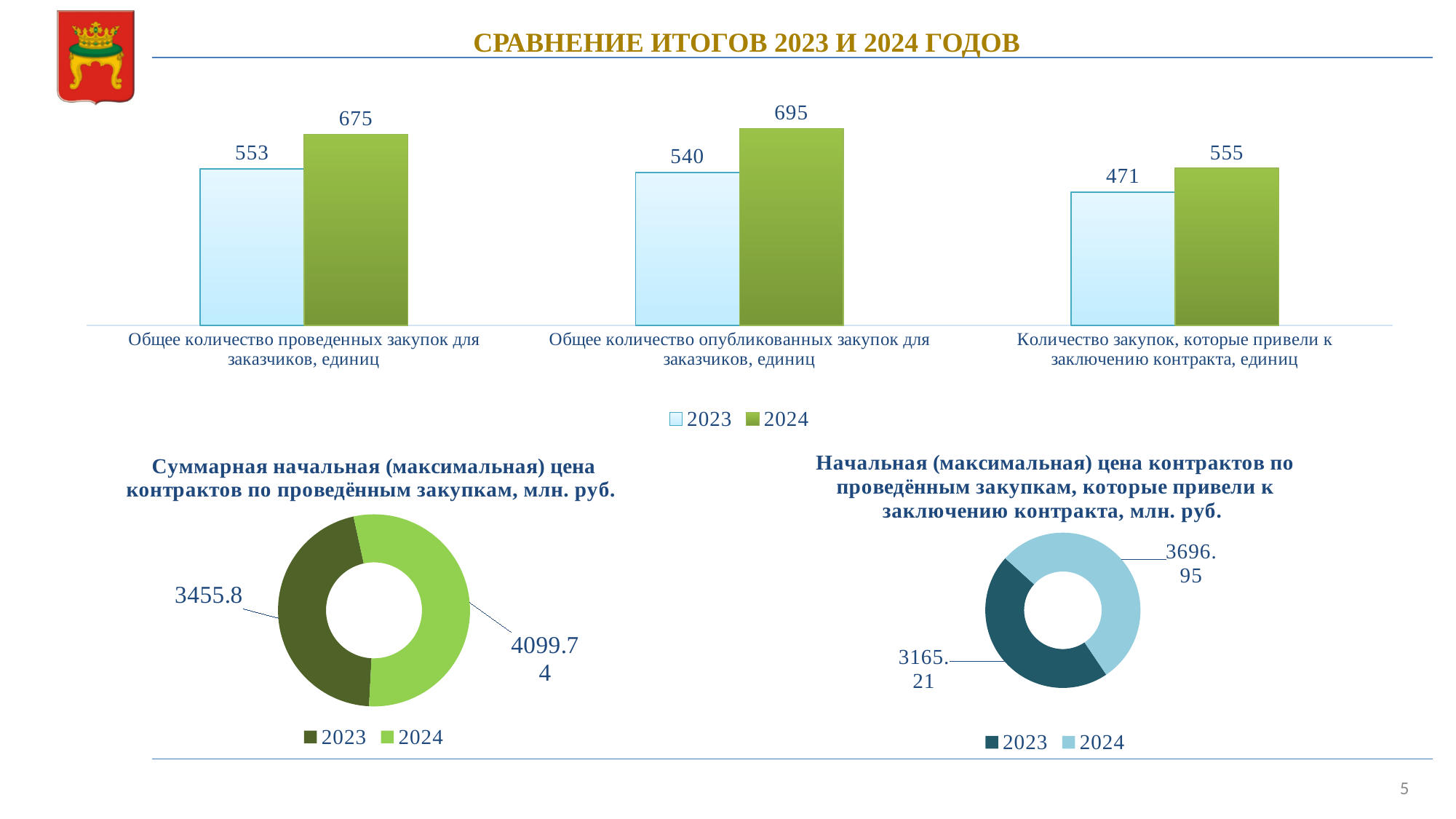
In the bar chart at the top of the slide, how many categories are shown on the x axis? 3 In the doughnut chart titled "Суммарная начальная (максимальная) цена контрактов по проведённым закупкам, млн. руб.", which year has the larger value, 2023 or 2024? 2024 In the bar chart at the top of the slide, how many series does the legend list? 2 In the doughnut chart titled "Начальная (максимальная) цена контрактов по проведённым закупкам, которые привели к заключению контракта, млн. руб.", what is the value for 2023? 3165.21 In the bar chart at the top of the slide, what is the 2023 value for "Общее количество опубликованных закупок для заказчиков, единиц"? 540 What type of chart is the chart at the top of the slide? bar chart In the bar chart at the top of the slide, what is the 2024 value for "Общее количество проведенных закупок для заказчиков, единиц"? 675 In the doughnut chart titled "Суммарная начальная (максимальная) цена контрактов по проведённым закупкам, млн. руб.", what is the value for 2024? 4099.74 In the bar chart at the top of the slide, which category has the highest 2024 value? Общее количество опубликованных закупок для заказчиков, единиц In the doughnut chart titled "Начальная (максимальная) цена контрактов по проведённым закупкам, которые привели к заключению контракта, млн. руб.", what is the difference between the 2024 and 2023 values? 531.74 In the bar chart at the top of the slide, what is the difference between the 2024 and 2023 values for "Общее количество опубликованных закупок для заказчиков, единиц"? 155 In the bar chart at the top of the slide, what is the 2023 value for "Количество закупок, которые привели к заключению контракта, единиц"? 471